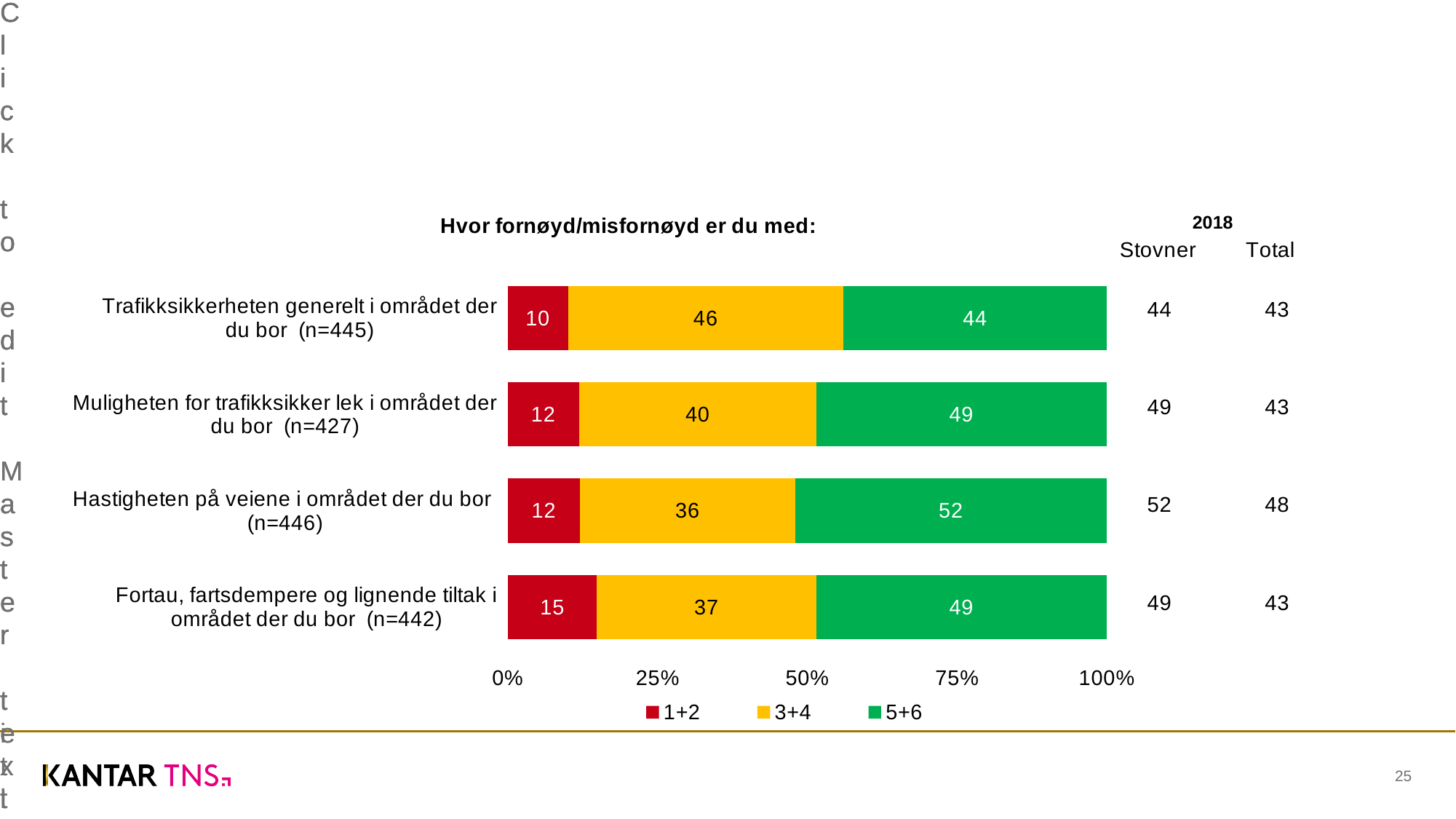
Which is larger: the 5+6 value for "Muligheten for trafikksikker lek i området der du bor" or the 5+6 value for "Trafikksikkerheten generelt i området der du bor"? Muligheten for trafikksikker lek i området der du bor How many categories are plotted in the chart? 4 Which category has the lowest 5+6 value? Trafikksikkerheten generelt i området der du bor (n=445) What is the title of the chart? Hvor fornøyd/misfornøyd er du med: How many series does the legend list? 3 What kind of chart is shown on the slide? Stacked bar chart What is the value of the 5+6 segment for "Hastigheten på veiene i området der du bor (n=446)"? 52 What is the total of the stacked bar for "Muligheten for trafikksikker lek i området der du bor (n=427)"? 101 What is the difference between the 3+4 values for "Trafikksikkerheten generelt i området der du bor" and "Hastigheten på veiene i området der du bor"? 10 What is the value of the 1+2 segment for "Trafikksikkerheten generelt i området der du bor (n=445)"? 10 Which category has the highest 1+2 value? Fortau, fartsdempere og lignende tiltak i området der du bor (n=442) What is the value of the 3+4 segment for "Fortau, fartsdempere og lignende tiltak i området der du bor (n=442)"? 37